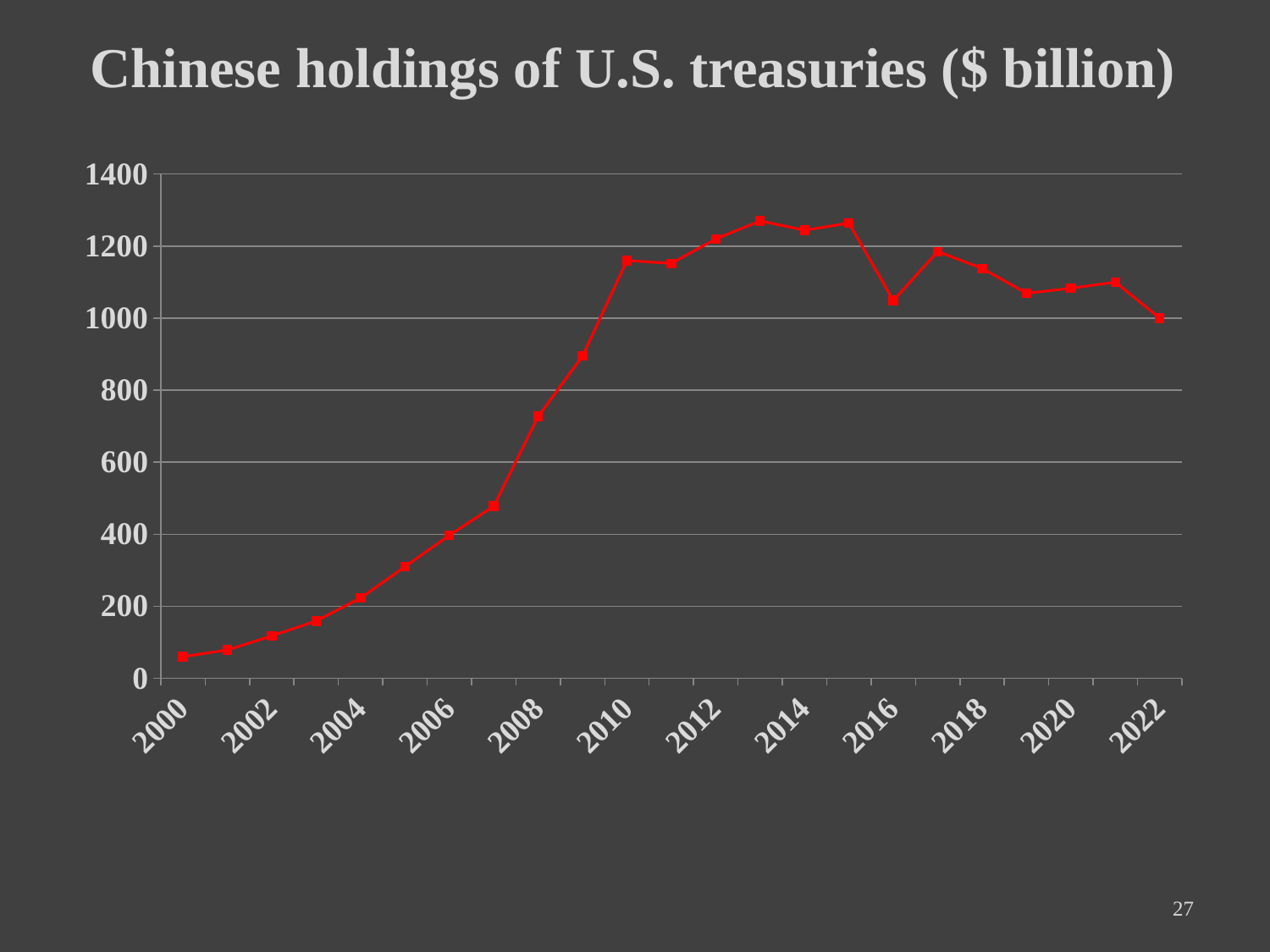
What is the title of the chart? Chinese holdings of U.S. treasuries ($ billion) Do the values rise or fall from 2000 to 2010? rise Is the value for 2003 greater or less than 200? less Which is larger, the value for 2016 or the value for 2017? 2017 Is the value for 2009 greater or less than 1000? less Is the value for 2013 greater or less than 1200? greater Which is larger, the value for 2005 or the value for 2010? 2010 How many data points are plotted on the line? 23 Which year has the lowest value? 2000 What kind of chart is shown on the slide? line chart